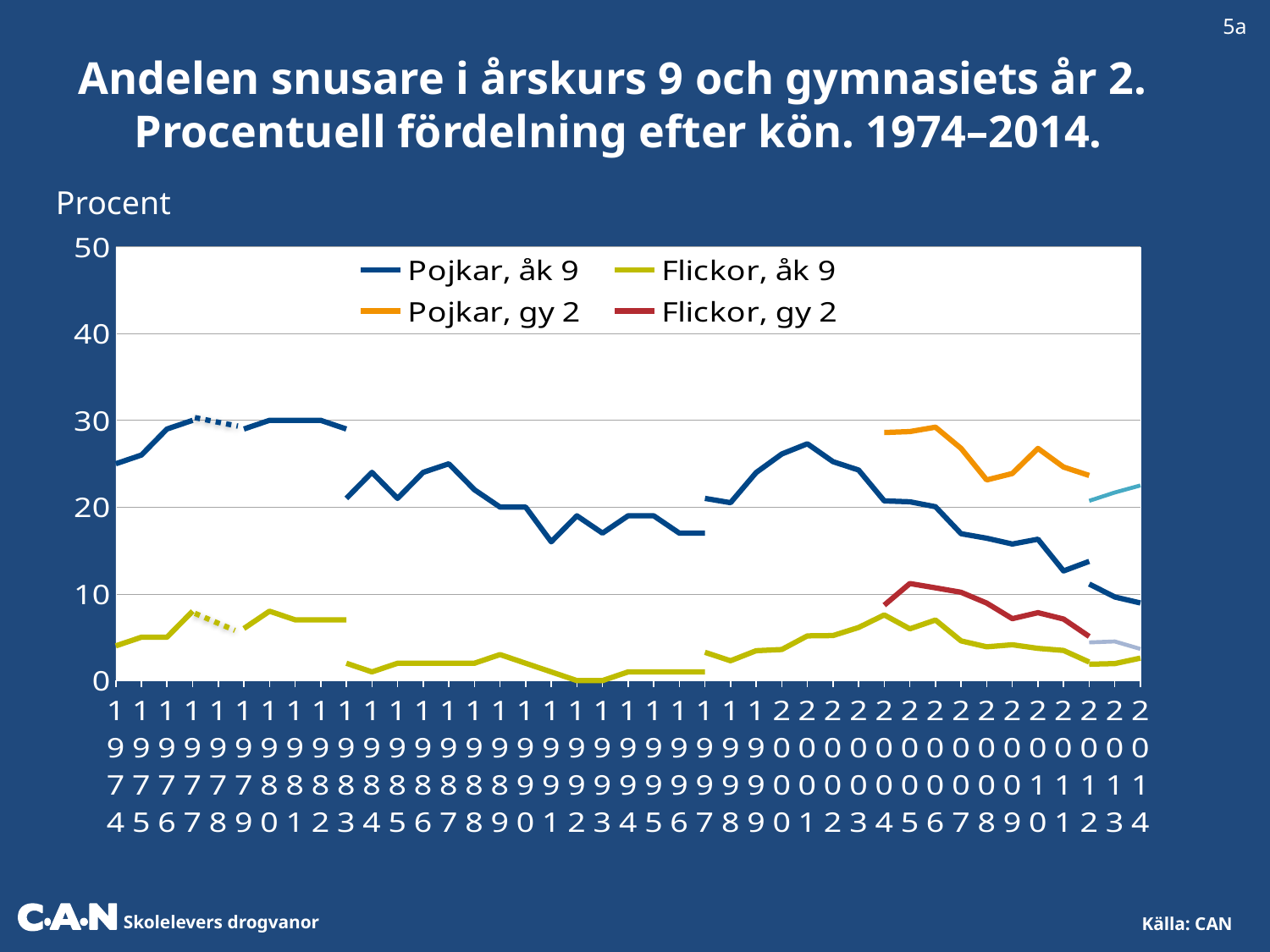
Which series has the highest value in 2010? Pojkar, gy 2 Does the value for Pojkar, åk 9 rise or fall overall from 2001 to 2014? fall Is the value for Pojkar, åk 9 in 1974 greater or less than 20? greater What kind of chart is shown on the slide? line chart Is the value for Flickor, åk 9 in 1992 greater or less than 10? less Which series are listed in the chart legend? Pojkar, åk 9; Flickor, åk 9; Pojkar, gy 2; Flickor, gy 2 Is the value for Flickor, gy 2 in 2012 greater or less than 10? less How many series does the chart legend list? 4 In 2000, which is larger: the value for Pojkar, åk 9 or the value for Flickor, åk 9? Pojkar, åk 9 What is the label shown above the vertical axis of the chart? Procent